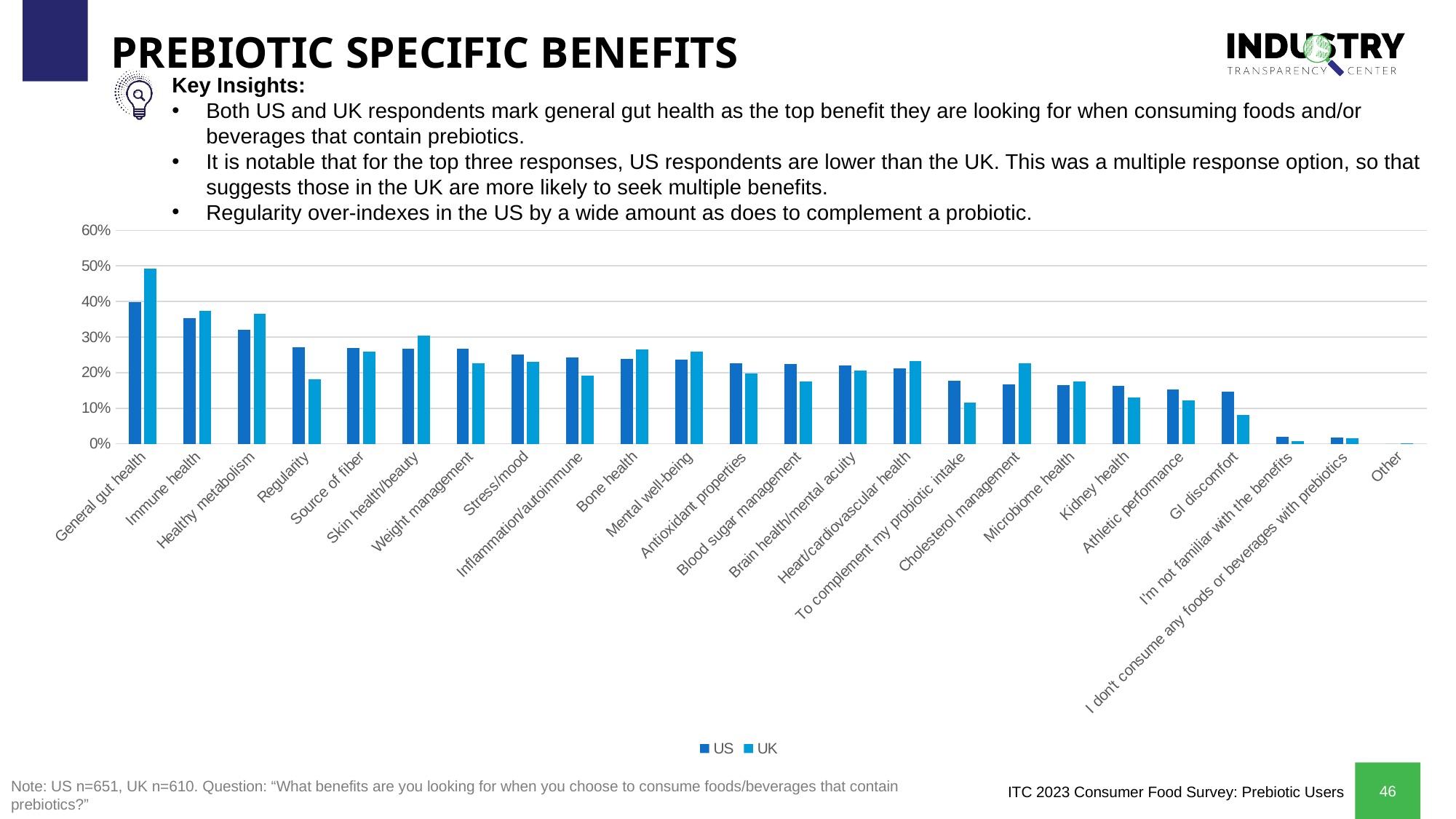
How many series does the legend list? 2 What kind of chart is shown on the slide? bar chart Is the UK value for Regularity greater or less than 20%? less For Regularity, which is larger, the US value or the UK value? US Is the UK value for GI discomfort greater or less than 10%? less Which category has the highest UK value? General gut health Is the US value for Healthy metabolism greater or less than 30%? greater Which category has the highest US value? General gut health Do the US values generally rise or fall moving from left to right along the x axis? fall How many benefit categories are shown on the x axis? 24 For Cholesterol management, which is larger, the US value or the UK value? UK